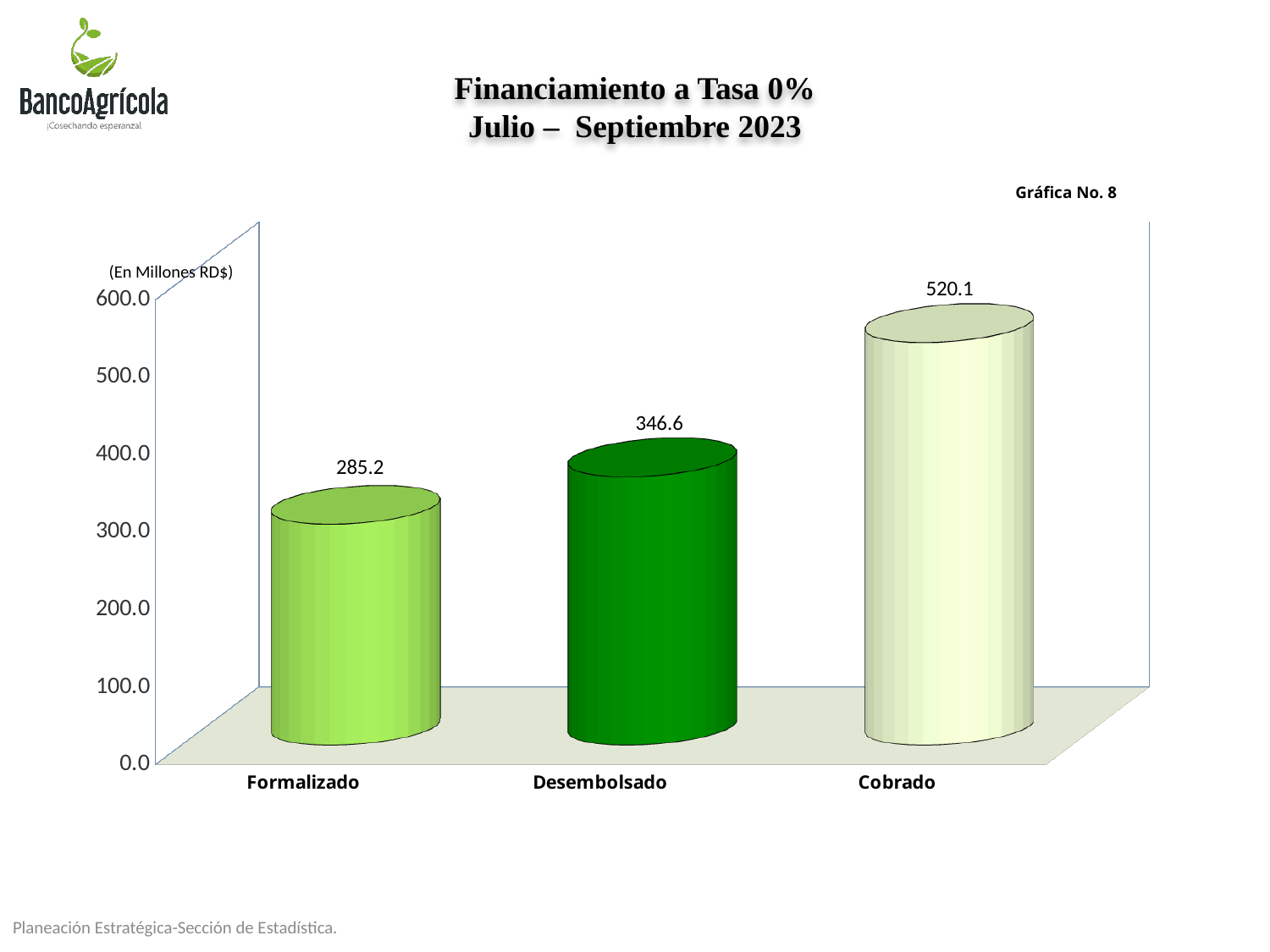
What is the value for Cobrado? 520.1 What unit is stated for the values in the chart? En Millones RD$ Is the value for Cobrado greater or less than 500.0? greater What is the value for Formalizado? 285.2 How many categories are shown on the x axis? 3 What is the difference between the values for Cobrado and Formalizado? 234.9 Which category has the lowest value? Formalizado Which category has the highest value? Cobrado What is the value for Desembolsado? 346.6 What kind of chart is shown on the slide? bar chart What is the difference between the values for Desembolsado and Formalizado? 61.4 Which is larger, the value for Desembolsado or the value for Cobrado? Cobrado